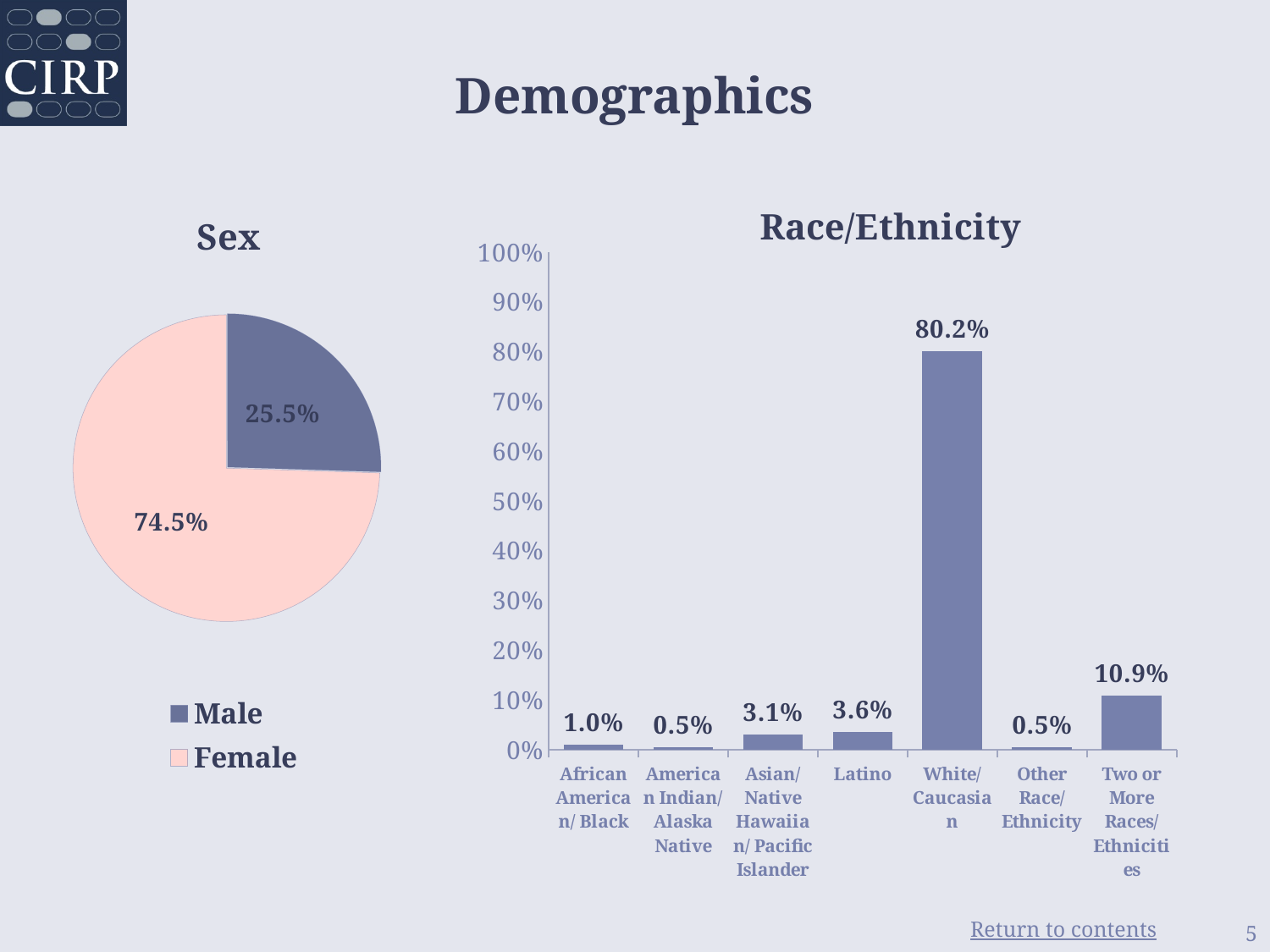
What kind of chart is the Race/Ethnicity chart? Bar chart In the Sex pie chart, what is the difference between the Female and Male shares? 49.0% In the Race/Ethnicity chart, how many categories are shown? 7 In the Race/Ethnicity chart, what is the value for White/Caucasian? 80.2% In the Sex pie chart, which category has the larger share? Female In the Race/Ethnicity chart, is the value for White/Caucasian greater or less than 70%? greater In the Race/Ethnicity chart, what is the value for Two or More Races/Ethnicities? 10.9% In the Race/Ethnicity chart, which category has the highest value? White/Caucasian In the Race/Ethnicity chart, what is the difference between Latino and Asian/Native Hawaiian/Pacific Islander? 0.5% In the Sex pie chart, what percentage is Female? 74.5% In the Sex pie chart, what percentage is Male? 25.5% What kind of chart is the Sex chart? Pie chart